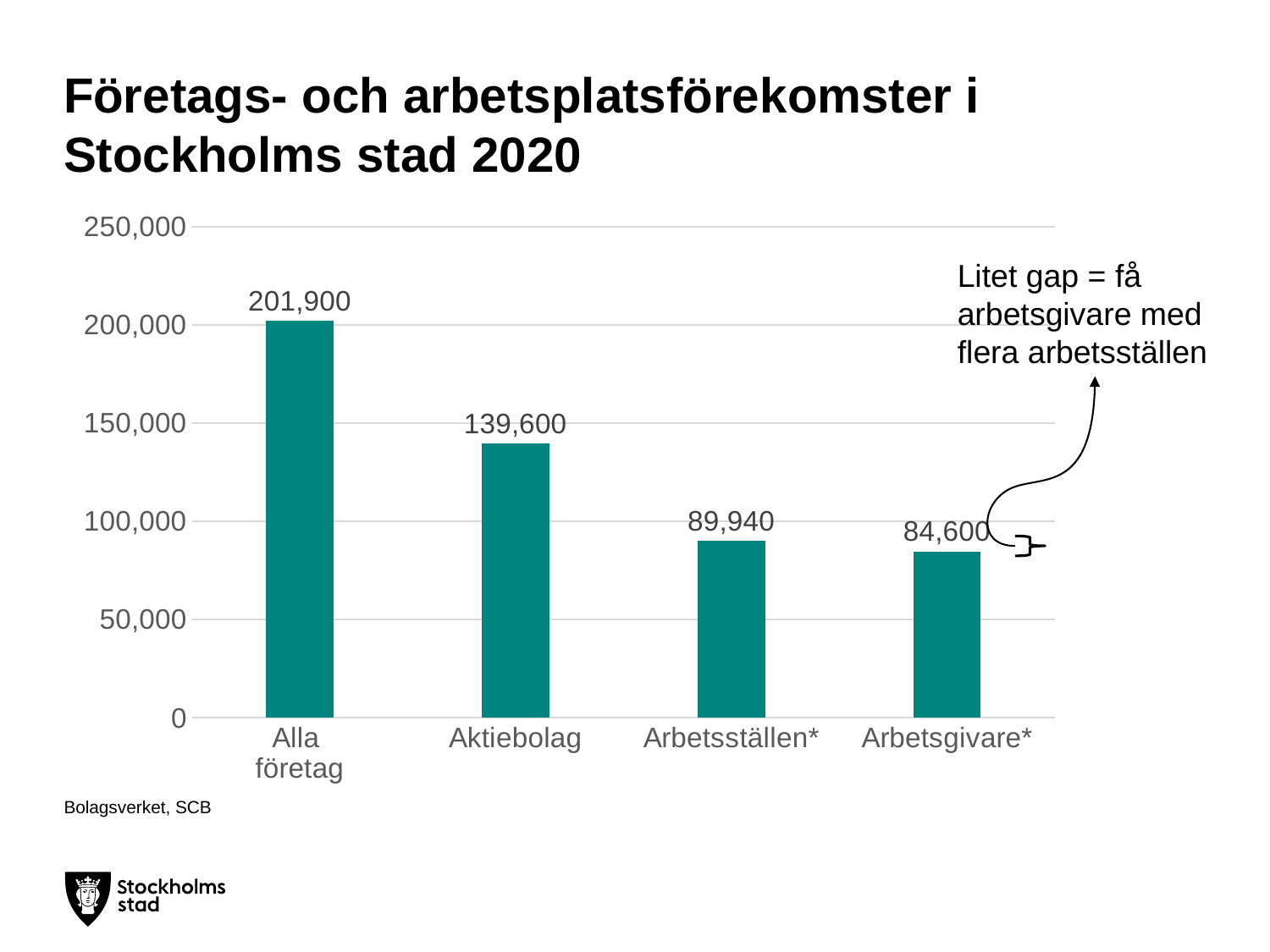
Which is larger, the value for Aktiebolag or the value for Arbetsställen*? Aktiebolag What is the value for Arbetsställen*? 89,940 What is the value for Aktiebolag? 139,600 What is the value for Alla företag? 201,900 What is the difference between the values for Alla företag and Aktiebolag? 62,300 How many categories are shown on the x axis? 4 Do the values rise or fall from left to right along the x axis? Fall What is the difference between the values for Arbetsställen* and Arbetsgivare*? 5,340 What is the value for Arbetsgivare*? 84,600 Which category has the lowest value? Arbetsgivare* What kind of chart is shown on the slide? Bar chart Which category has the highest value? Alla företag